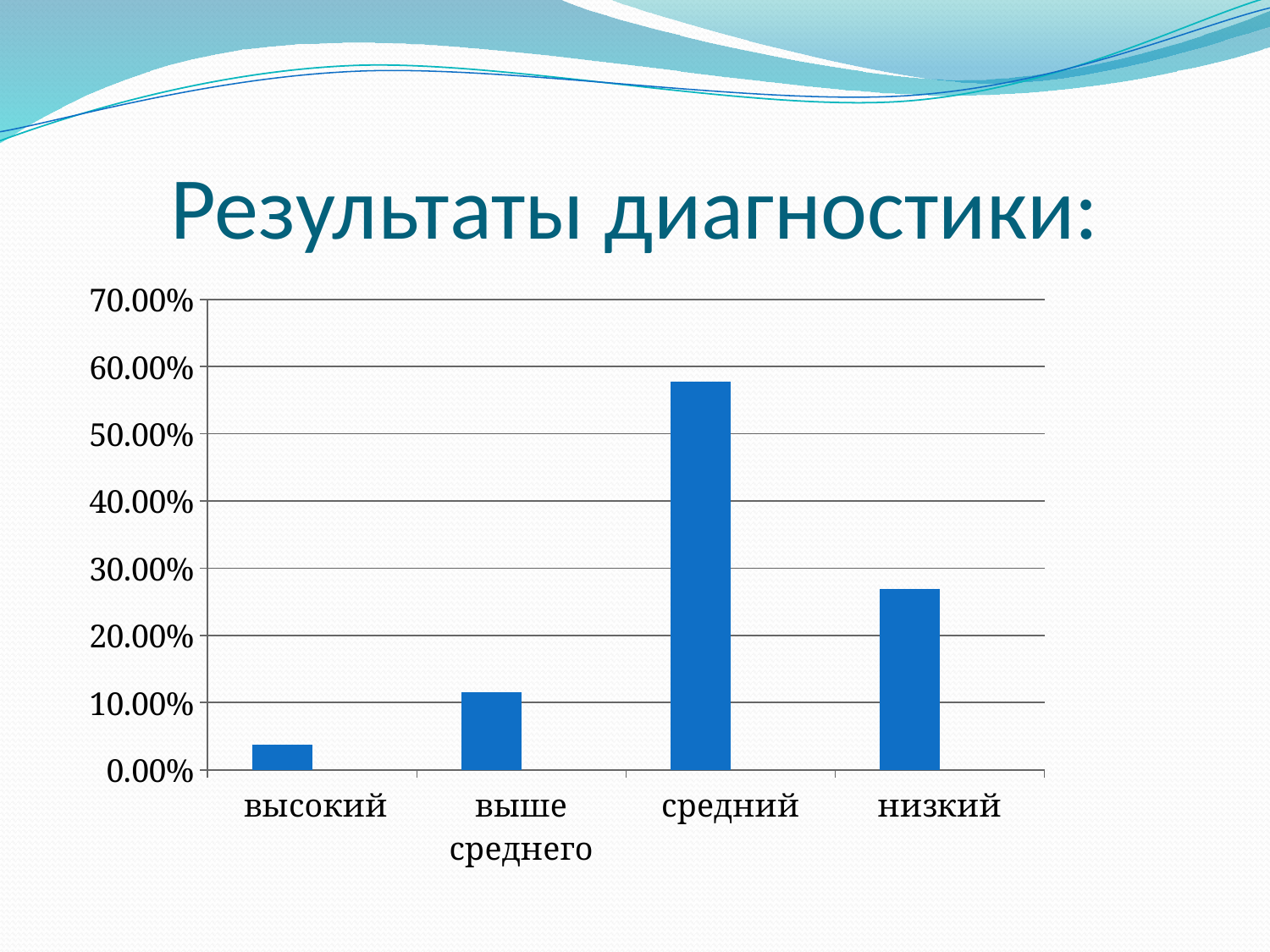
Is the value for низкий greater or less than 30.00%? less How many categories are shown on the x axis? 4 Which category has the lowest bar? высокий Is the value for средний greater or less than 50.00%? greater Which category has the highest bar? средний Which is larger, the value for средний or the value for низкий? средний Is the value for высокий greater or less than 10.00%? less What kind of chart is shown on the slide? bar chart What is the title of the slide? Результаты диагностики: Which is larger, the value for низкий or the value for выше среднего? низкий What is the highest value shown on the y axis? 70.00%